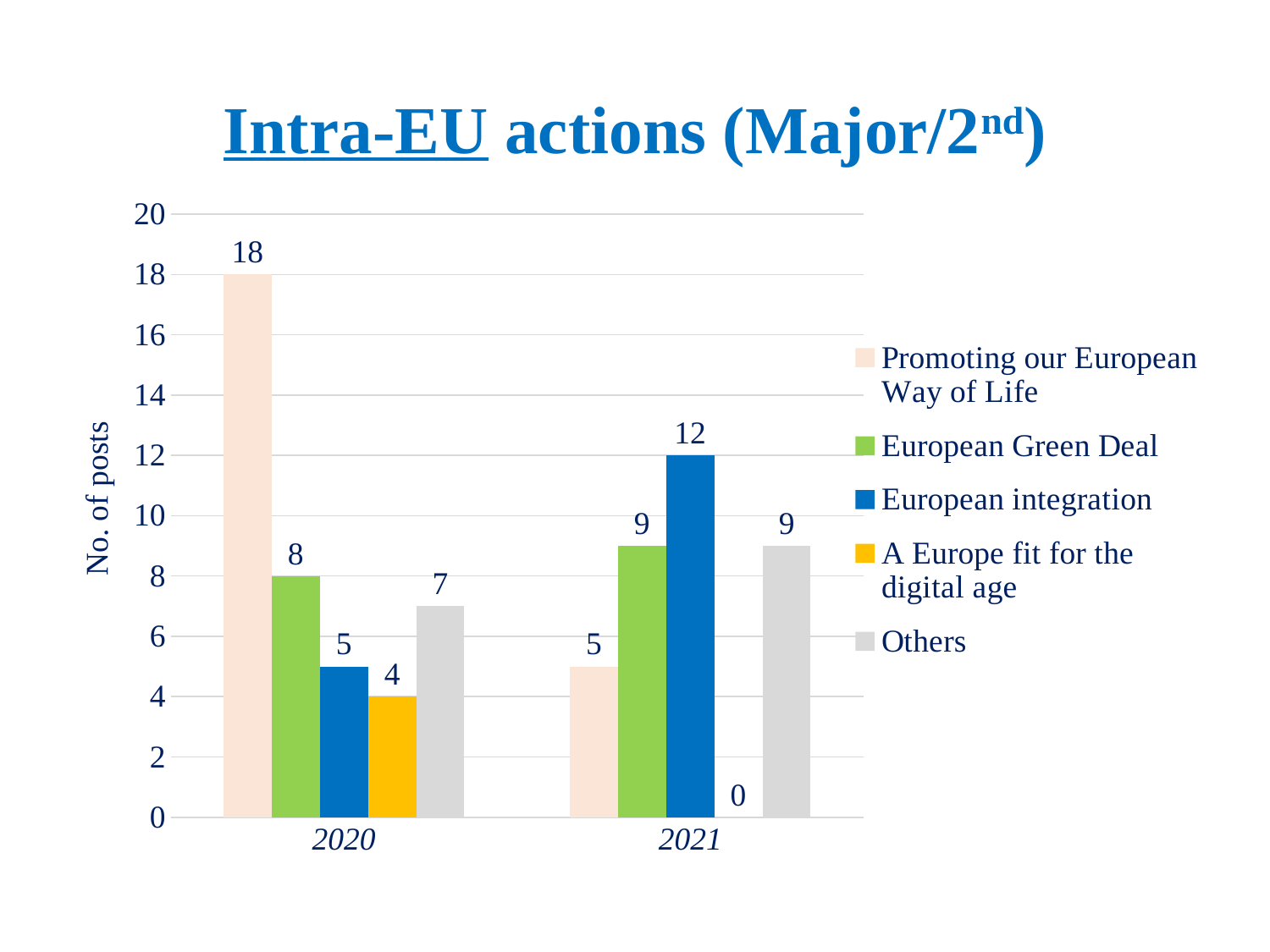
Which series has the highest value in 2020? Promoting our European Way of Life Which is larger: European Green Deal in 2020 or European Green Deal in 2021? European Green Deal in 2021 Does the value for European integration rise or fall from 2020 to 2021? Rise What kind of chart is shown on the slide? Bar chart What is the difference between the Promoting our European Way of Life values for 2020 and 2021? 13 How many series does the legend list? 5 What is the value for European integration in 2021? 12 Which series has the lowest value in 2021? A Europe fit for the digital age What is the value for Others in 2020? 7 What is the value for A Europe fit for the digital age in 2021? 0 What is the value for Promoting our European Way of Life in 2020? 18 What is the label of the vertical axis? No. of posts